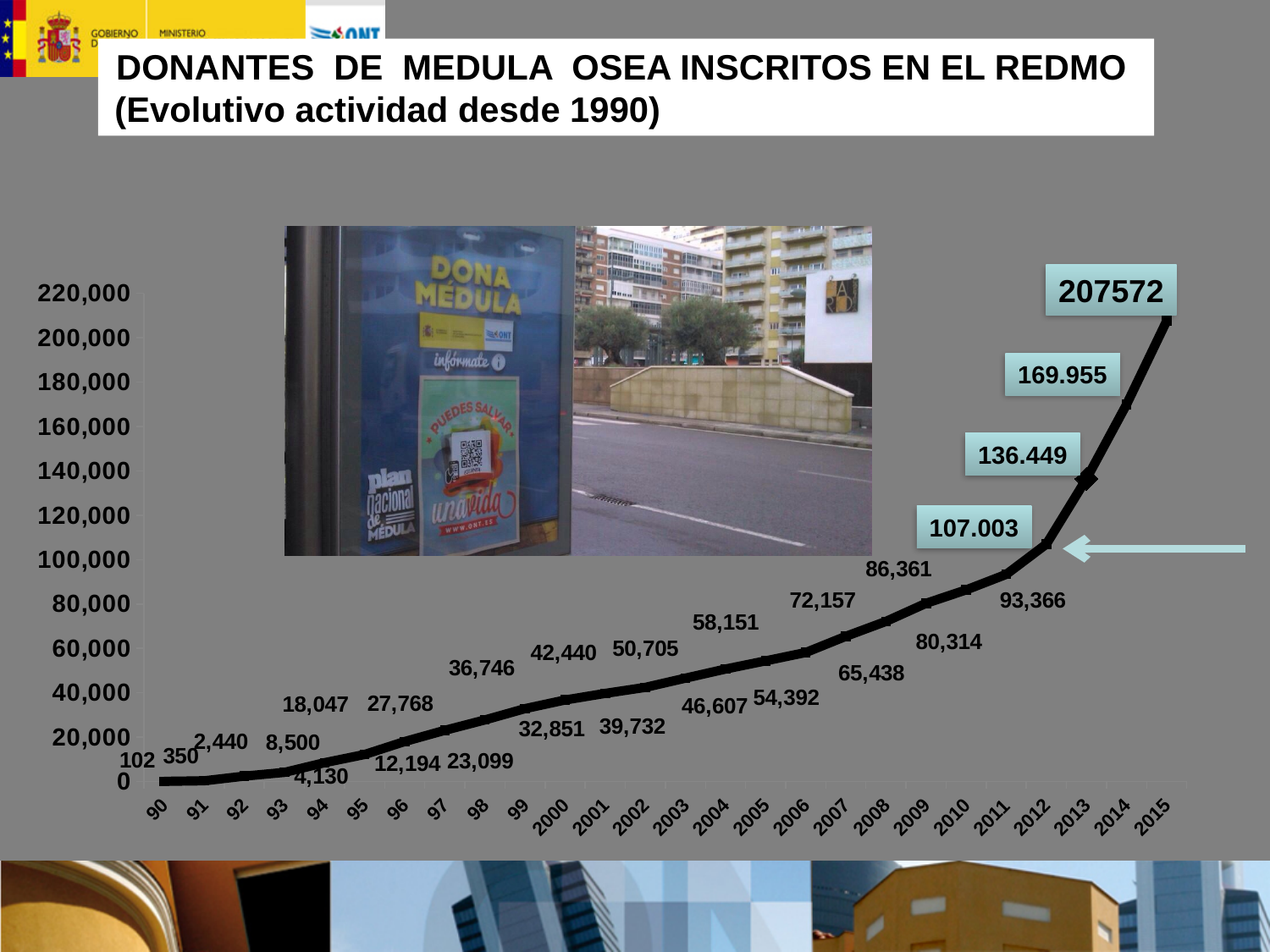
Do the values rise or fall from 90 to 2015? rise What is the value for 2010? 86,361 Which is larger, the value for 2008 or the value for 2006? 2008 Which year has the lowest value? 90 Is the value for 2013 greater or less than 120,000? greater What is the difference between the values for 2010 and 2009? 6,047 What is the value for 2012? 107.003 What is the value for 2015? 207572 Which year has the highest value? 2015 What kind of chart is shown? line chart How many years are plotted on the x axis? 26 What is the value for 90? 102